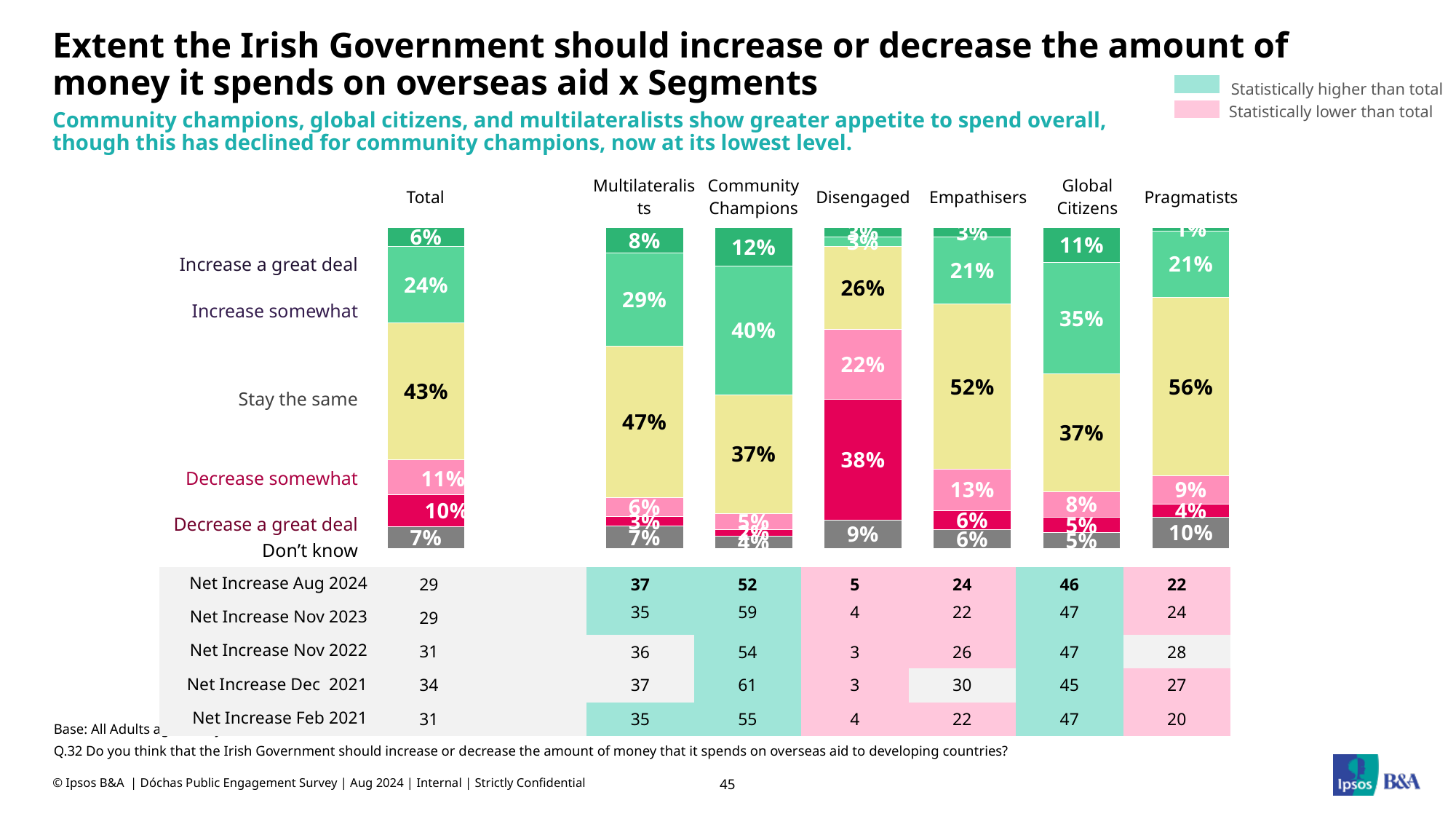
How many segment bars are shown in the stacked bar chart? 7 What percentage of Pragmatists say 'Stay the same'? 56% Which segment has the highest 'Stay the same' percentage? Pragmatists What percentage of the Total segment say the government should 'Stay the same' on overseas aid spending? 43% What percentage of Community Champions say 'Increase somewhat'? 40% Which is larger: the 'Increase a great deal' percentage for Community Champions or for Global Citizens? Community Champions What is the difference between the 'Increase somewhat' percentage for Global Citizens and for Empathisers? 14% What type of chart is used to show the response breakdown by segment? Stacked bar chart What is the Net Increase Aug 2024 value for Community Champions in the table? 52 According to the legend, what does the green shading in the table indicate? Statistically higher than total Which segment has the highest 'Decrease a great deal' percentage? Disengaged What percentage of the Disengaged segment say 'Decrease a great deal'? 38%